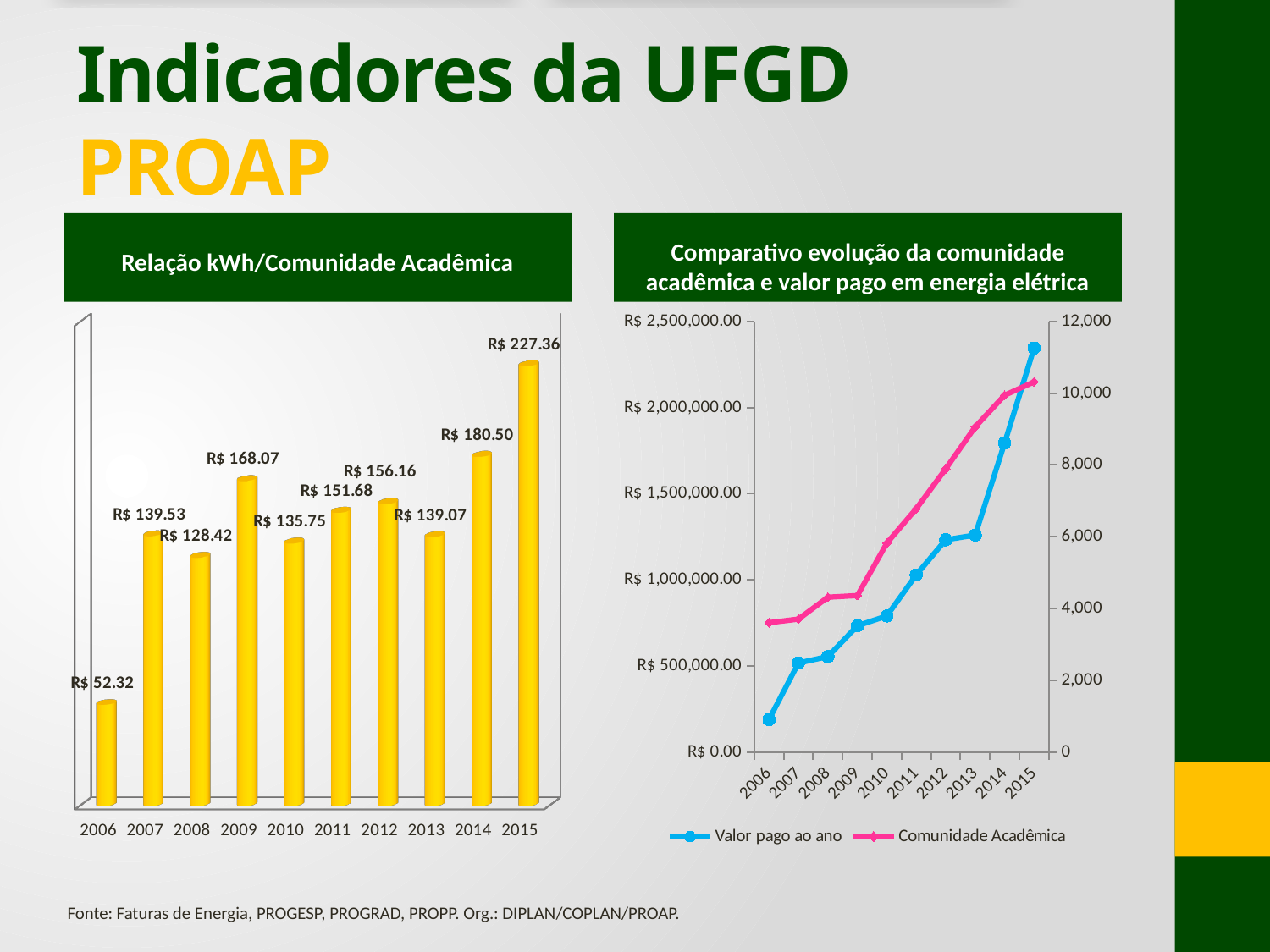
In the chart on the right, does the "Comunidade Acadêmica" series rise or fall from 2006 to 2015? Rise In the chart titled "Relação kWh/Comunidade Acadêmica", how many years are shown? 10 In the chart on the right, what colour is the "Valor pago ao ano" line? Blue In the chart titled "Relação kWh/Comunidade Acadêmica", which year has the highest value? 2015 In the chart titled "Relação kWh/Comunidade Acadêmica", what is the value for 2009? R$ 168.07 In the chart titled "Relação kWh/Comunidade Acadêmica", which is larger, the value for 2007 or the value for 2008? 2007 In the chart titled "Relação kWh/Comunidade Acadêmica", what is the difference between the values for 2015 and 2014? R$ 46.86 In the chart on the right, is the value of "Valor pago ao ano" for 2015 greater or less than R$ 2,000,000.00? greater What kind of chart is the one titled "Relação kWh/Comunidade Acadêmica"? Bar chart In the chart titled "Relação kWh/Comunidade Acadêmica", which year has the lowest value? 2006 In the chart on the right, how many series does the legend list? 2 In the chart titled "Relação kWh/Comunidade Acadêmica", what is the value for 2006? R$ 52.32